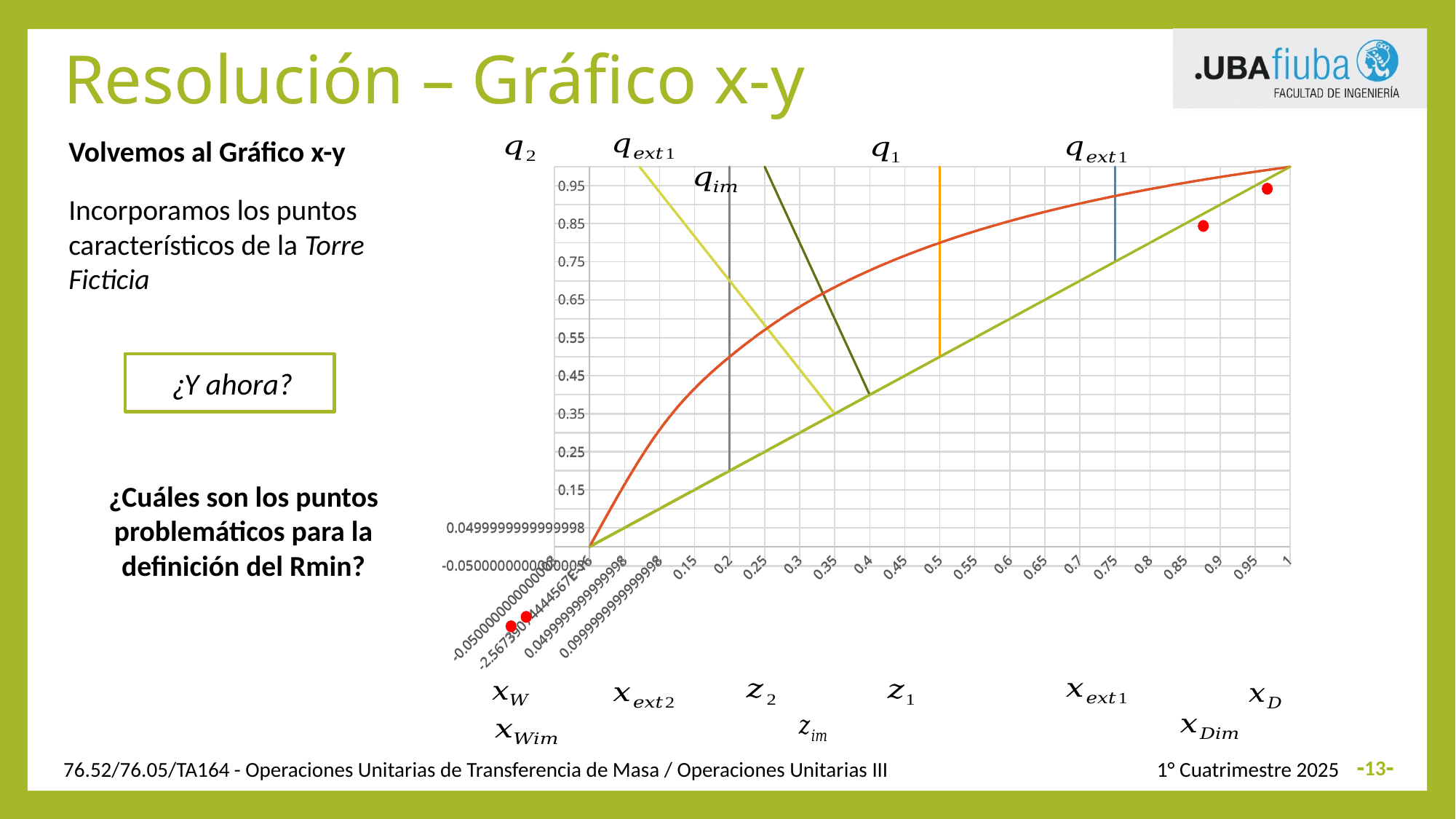
How many red dot markers are plotted on the chart? 4 Is the value of the curved red line at x = 0.5 greater or less than 0.65? greater Does the curved red line rise or fall as x increases from 0 to 1? rise Is the value of the curved red line at x = 0.2 greater or less than 0.35? greater At x = 0.5, which is larger: the curved red line or the straight green diagonal line? the curved red line What is the largest tick value shown on the x axis? 1 Is the value of the curved red line at x = 0.85 greater or less than 0.75? greater What is the highest tick value shown on the y axis? 0.95 What kind of chart is shown on the slide? line chart